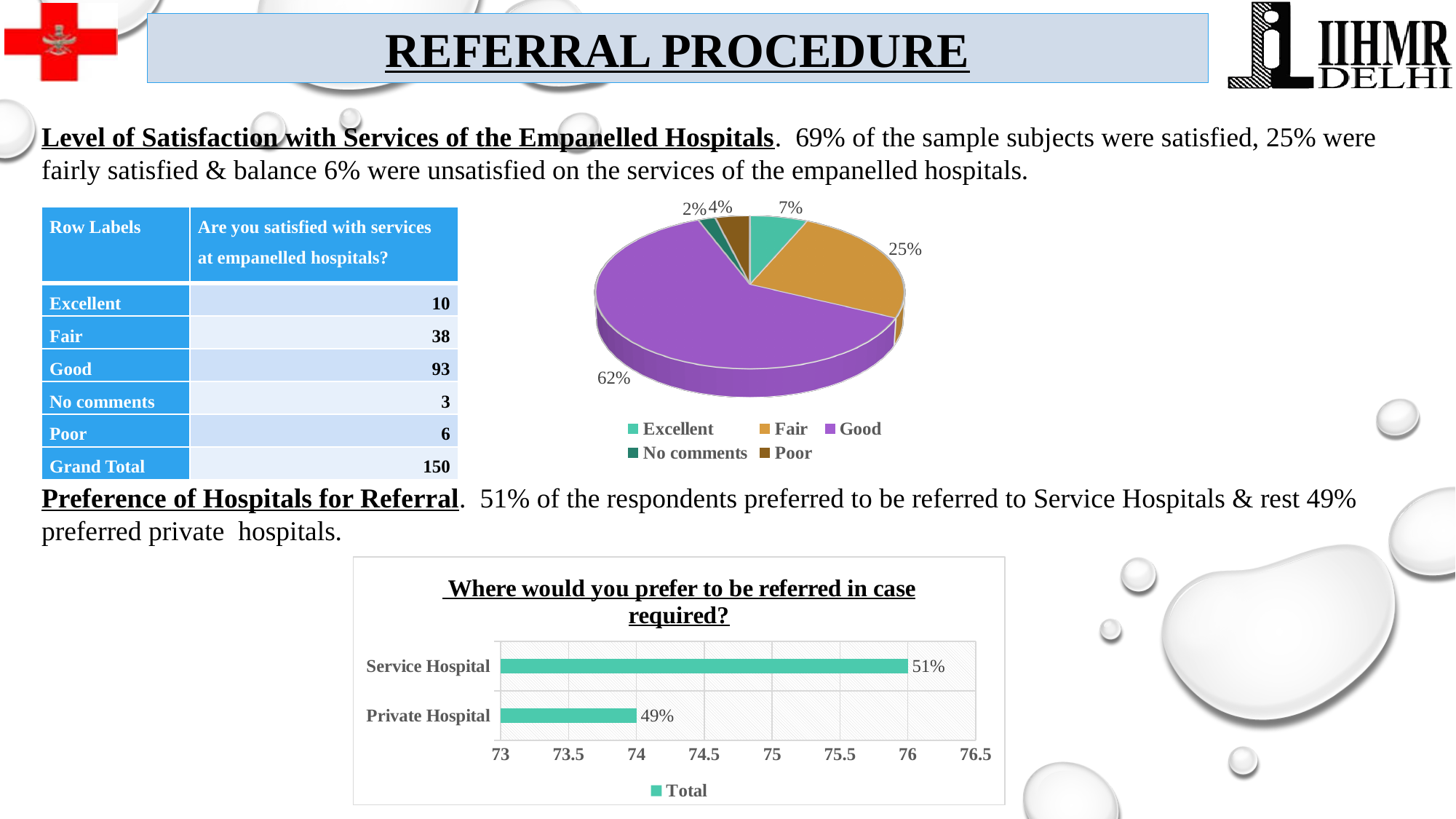
On the pie chart, which category has the smallest slice? No comments In the chart titled 'Where would you prefer to be referred in case required?', what is the value for Private Hospital? 49% On the pie chart, what is the difference in percentage points between the Good slice and the Fair slice? 37 What kind of chart is the chart titled 'Where would you prefer to be referred in case required?'? bar chart On the pie chart, what share of the pie does the Fair slice represent? 25% In the chart titled 'Where would you prefer to be referred in case required?', how many series does the legend list? 1 In the chart titled 'Where would you prefer to be referred in case required?', what is the value for Service Hospital? 51% On the pie chart, what share of the pie does the Excellent slice represent? 7% On the pie chart, which slice is larger, Poor or No comments? Poor On the pie chart, which category has the largest slice? Good On the pie chart, how many categories does the legend list? 5 On the pie chart, what share of the pie does the Good slice represent? 62%